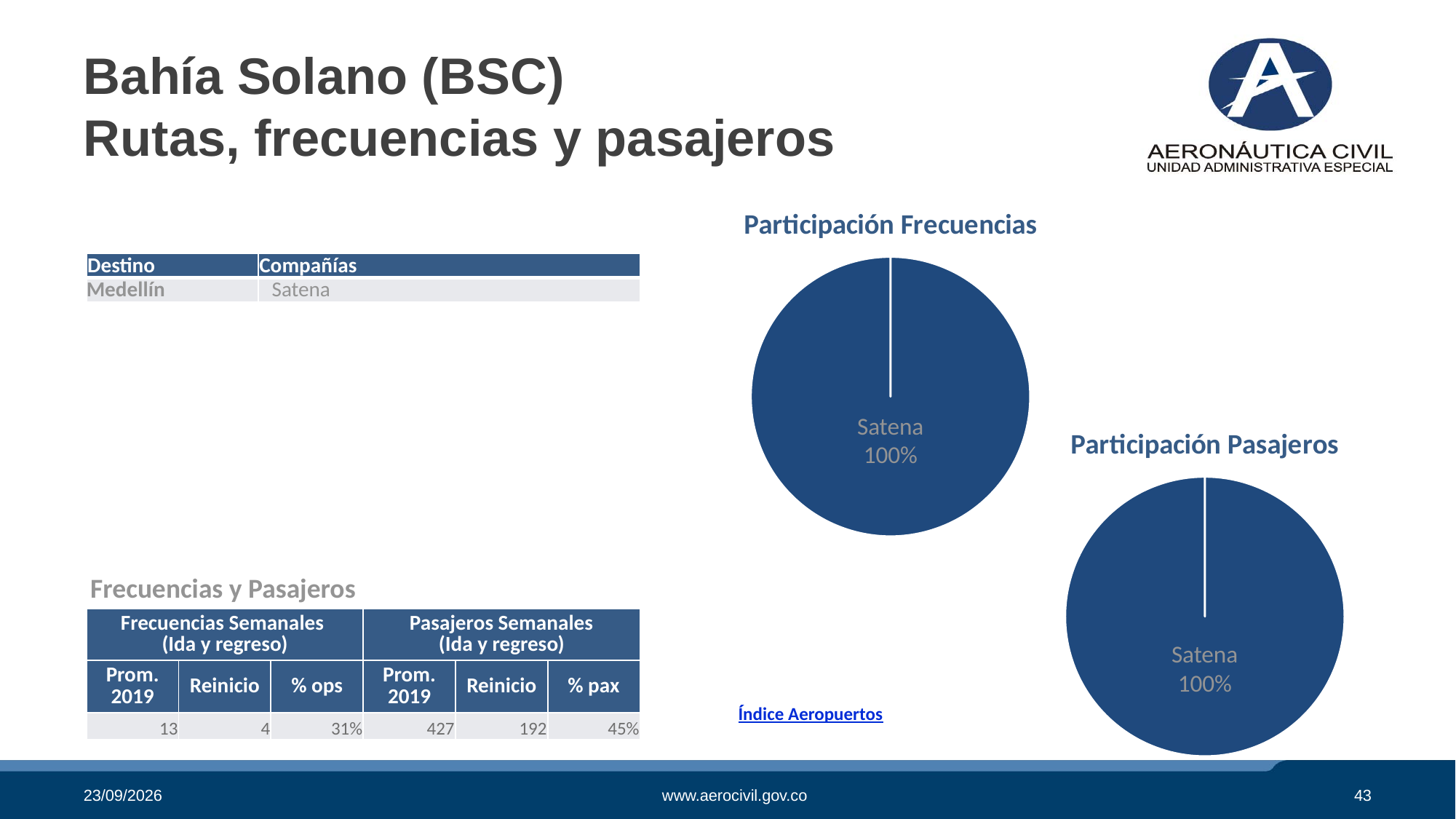
What is the title of the pie chart in the upper right of the slide? Participación Frecuencias What kind of chart is 'Participación Pasajeros'? Pie chart What is the title of the pie chart in the lower right of the slide? Participación Pasajeros How many slices does the 'Participación Frecuencias' pie chart have? 1 In the 'Participación Pasajeros' chart, what share does Satena have? 100% In the 'Participación Frecuencias' chart, what share does Satena have? 100% How many slices does the 'Participación Pasajeros' pie chart have? 1 In the 'Participación Frecuencias' chart, is Satena's share greater or less than 50%? greater What kind of chart is 'Participación Frecuencias'? Pie chart In the 'Participación Pasajeros' chart, is Satena's share greater or less than 50%? greater In the 'Participación Pasajeros' chart, which company is labelled on the pie? Satena In the 'Participación Frecuencias' chart, which company is labelled on the pie? Satena